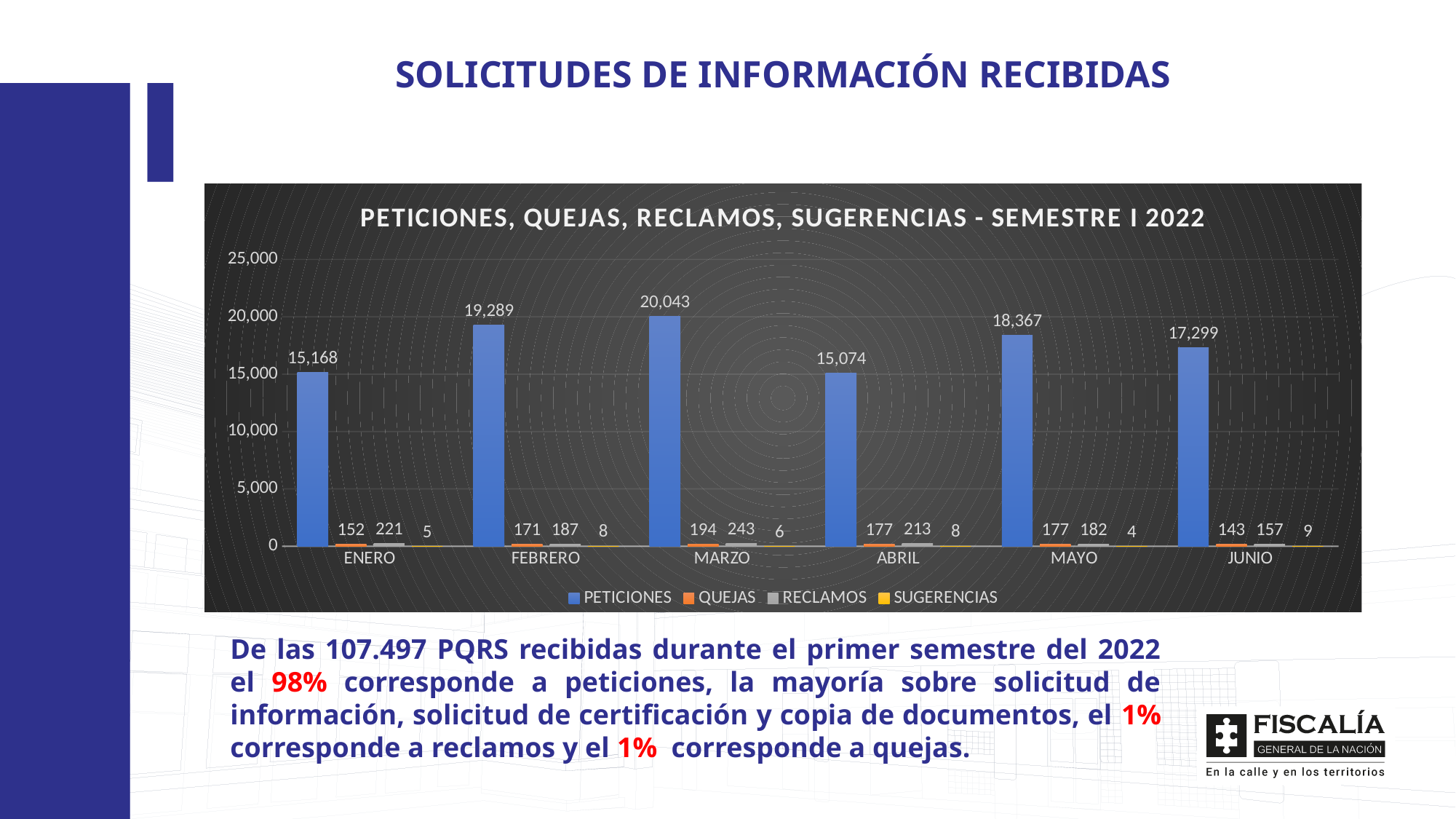
How many months are shown on the x axis? 6 What is the value of SUGERENCIAS for JUNIO? 9 What is the title of the chart? PETICIONES, QUEJAS, RECLAMOS, SUGERENCIAS - SEMESTRE I 2022 How many series does the legend list? 4 What is the value of PETICIONES for MARZO? 20,043 Is the value of PETICIONES for MAYO greater or less than 15,000? greater Which month has the lowest value for PETICIONES? ABRIL What is the value of RECLAMOS for ABRIL? 213 Which month has the highest value for PETICIONES? MARZO What is the value of QUEJAS for FEBRERO? 171 Which is larger: RECLAMOS in ENERO or RECLAMOS in MAYO? RECLAMOS in ENERO What is the difference between PETICIONES in FEBRERO and PETICIONES in JUNIO? 1,990